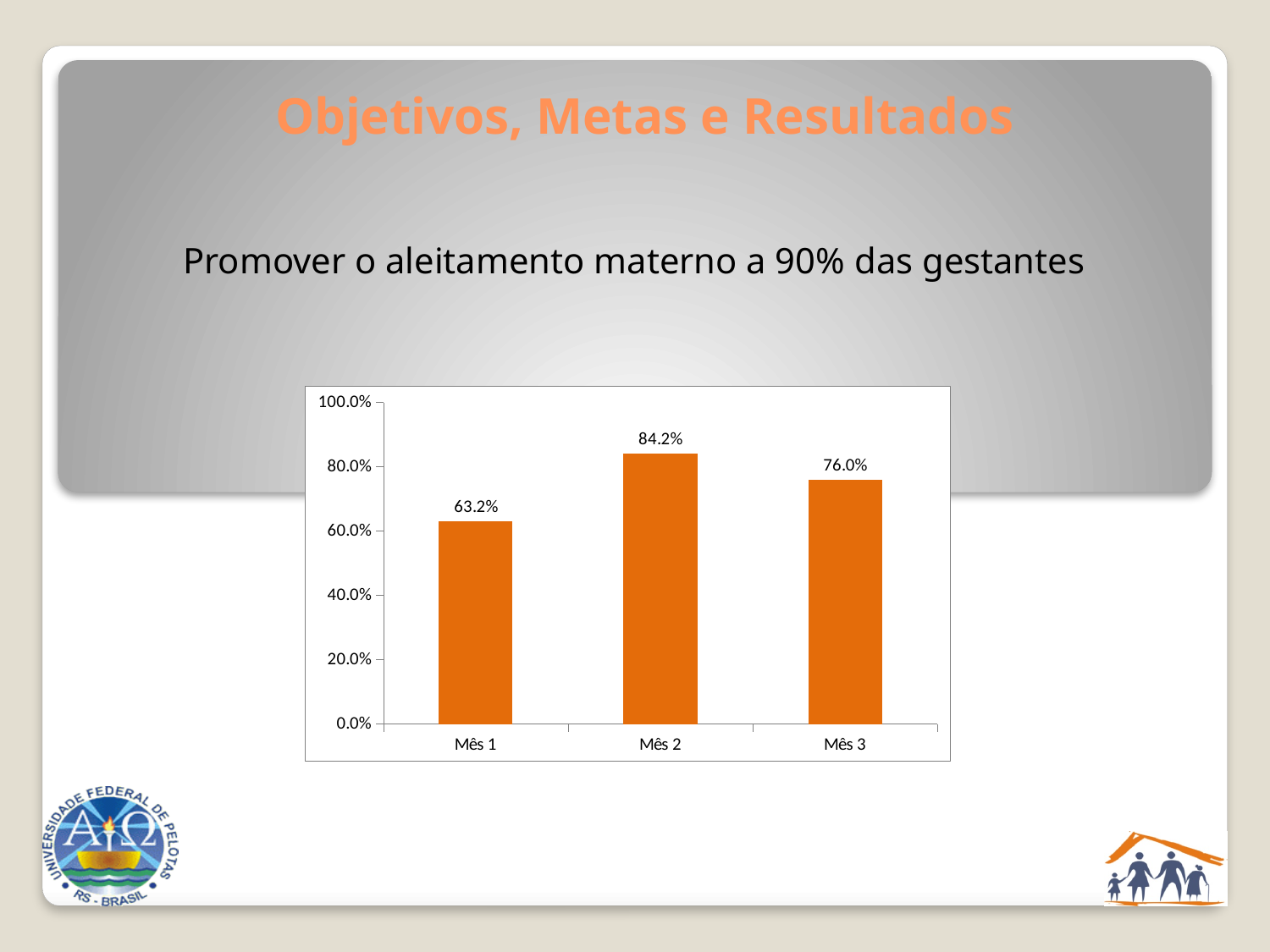
What is the value for Mês 2? 84.2% What kind of chart is shown on the slide? bar chart Which is larger, the value for Mês 3 or the value for Mês 1? Mês 3 How many months are shown on the x axis? 3 What is the value for Mês 1? 63.2% Which month has the highest value? Mês 2 Which month has the lowest value? Mês 1 What is the difference between the values for Mês 2 and Mês 3? 8.2% What is the value for Mês 3? 76.0% Is the value for Mês 2 greater or less than 80.0%? greater What colour are the bars in the chart? orange What is the difference between the values for Mês 2 and Mês 1? 21.0%